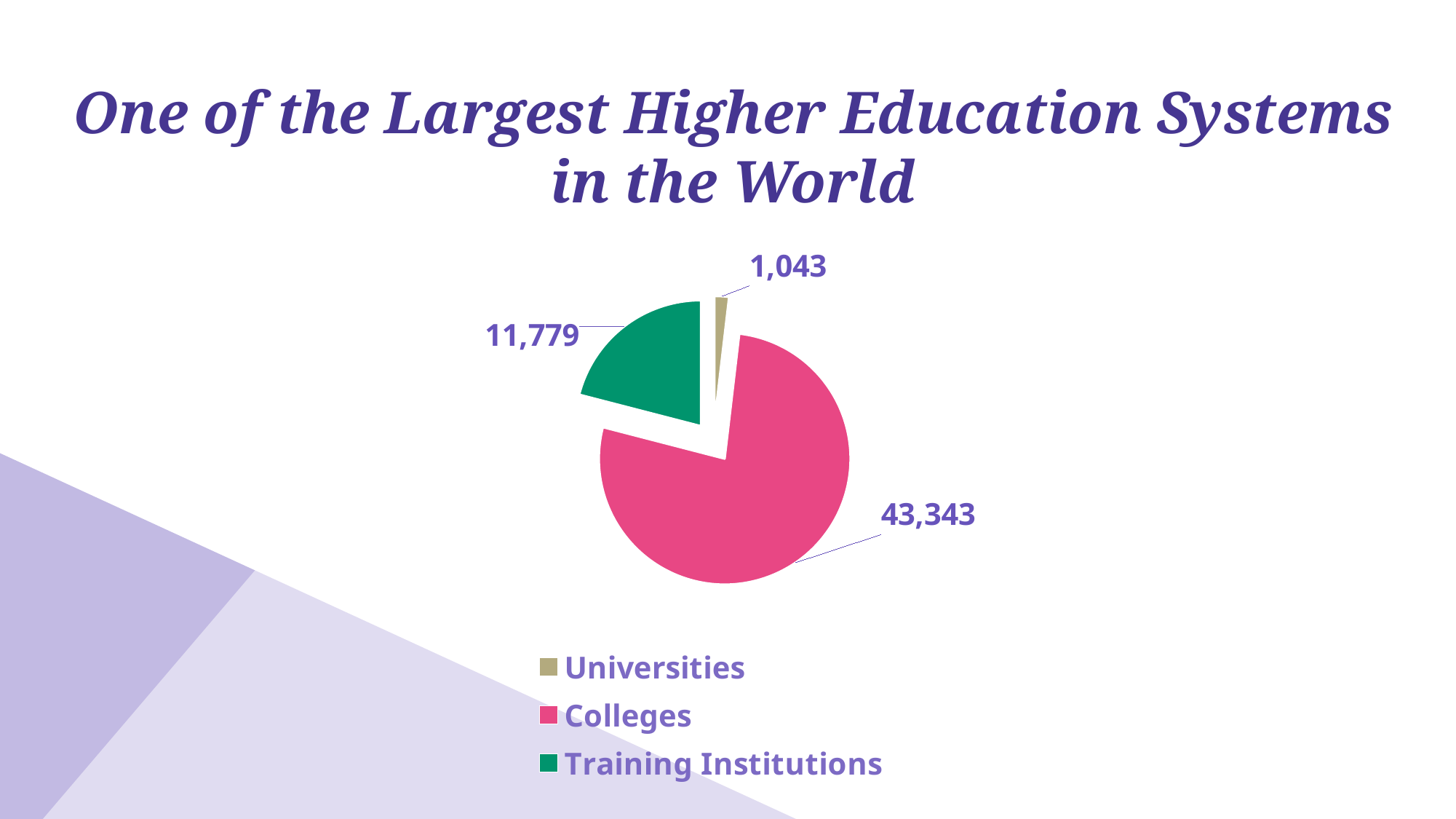
How many categories does the pie chart show? 3 What is the value for Universities? 1,043 Which category has the largest slice of the pie? Colleges What share of the pie does the Colleges slice represent, to the nearest whole percent? 77% What is the value for Training Institutions? 11,779 What is the difference between the values for Colleges and Training Institutions? 31,564 Which is larger, the value for Training Institutions or the value for Universities? Training Institutions Which category has the smallest slice of the pie? Universities What is the difference between the values for Training Institutions and Universities? 10,736 What is the value for Colleges? 43,343 What type of chart is shown on the slide? pie chart What colour is the Training Institutions slice? green